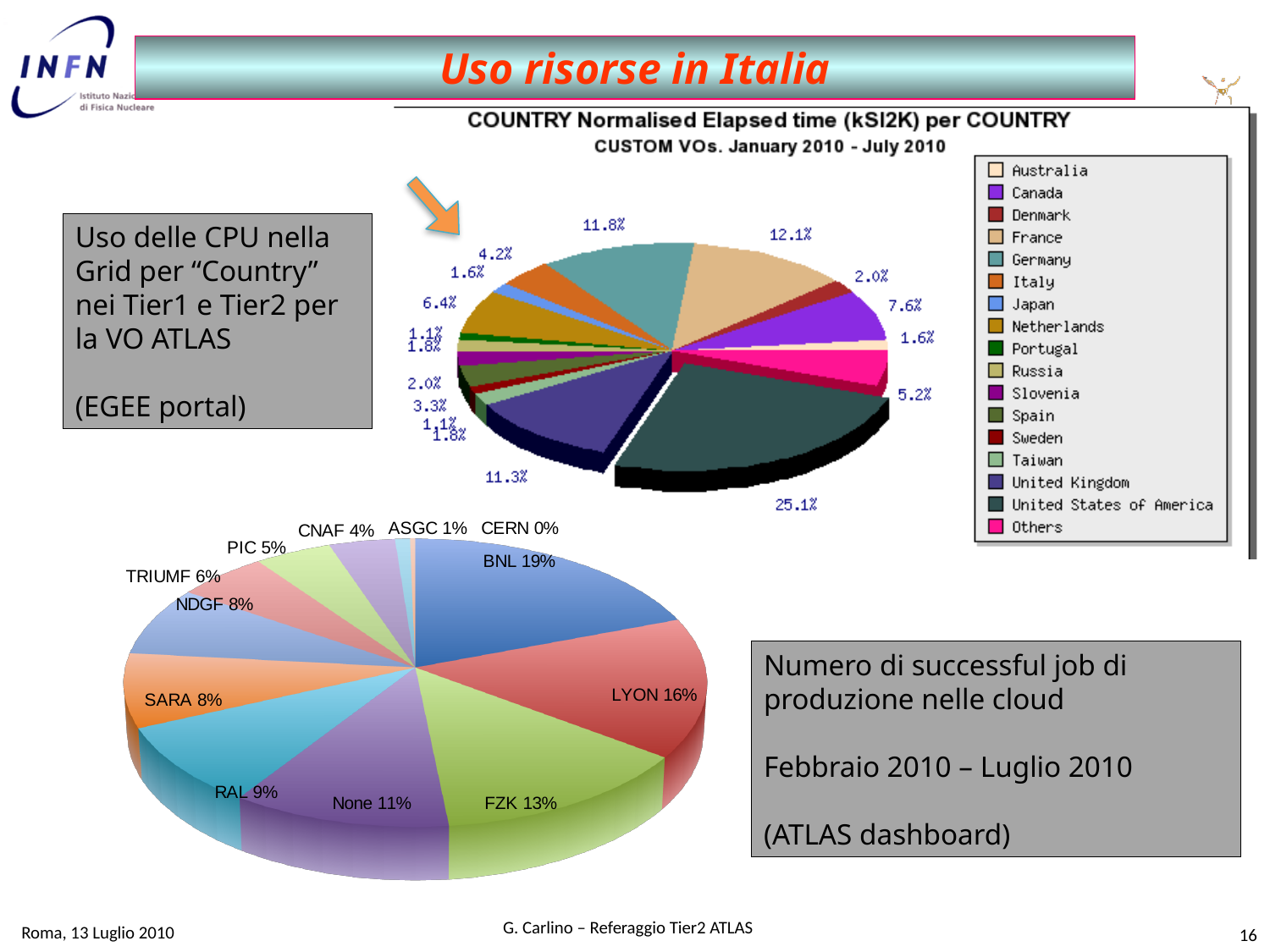
How many entries does the legend of the top chart 'COUNTRY Normalised Elapsed time (kSI2K) per COUNTRY' list? 17 How many categories are shown in the bottom pie chart? 12 In the bottom pie chart, what is the difference between the shares of LYON and RAL? 7% In the bottom pie chart, what is the share for FZK? 13% What period is stated in the subtitle of the top chart 'COUNTRY Normalised Elapsed time (kSI2K) per COUNTRY'? January 2010 - July 2010 What kind of chart is the bottom chart on the slide? Pie chart In the bottom pie chart, which category has the smallest slice? CERN In the bottom pie chart, which category has the largest slice? BNL In the bottom pie chart, what is the share for SARA? 8% In the bottom pie chart, which is larger, the share for TRIUMF or the share for PIC? TRIUMF In the top chart titled 'COUNTRY Normalised Elapsed time (kSI2K) per COUNTRY', what is the largest slice's percentage? 25.1% In the bottom pie chart, what is the share for BNL? 19%